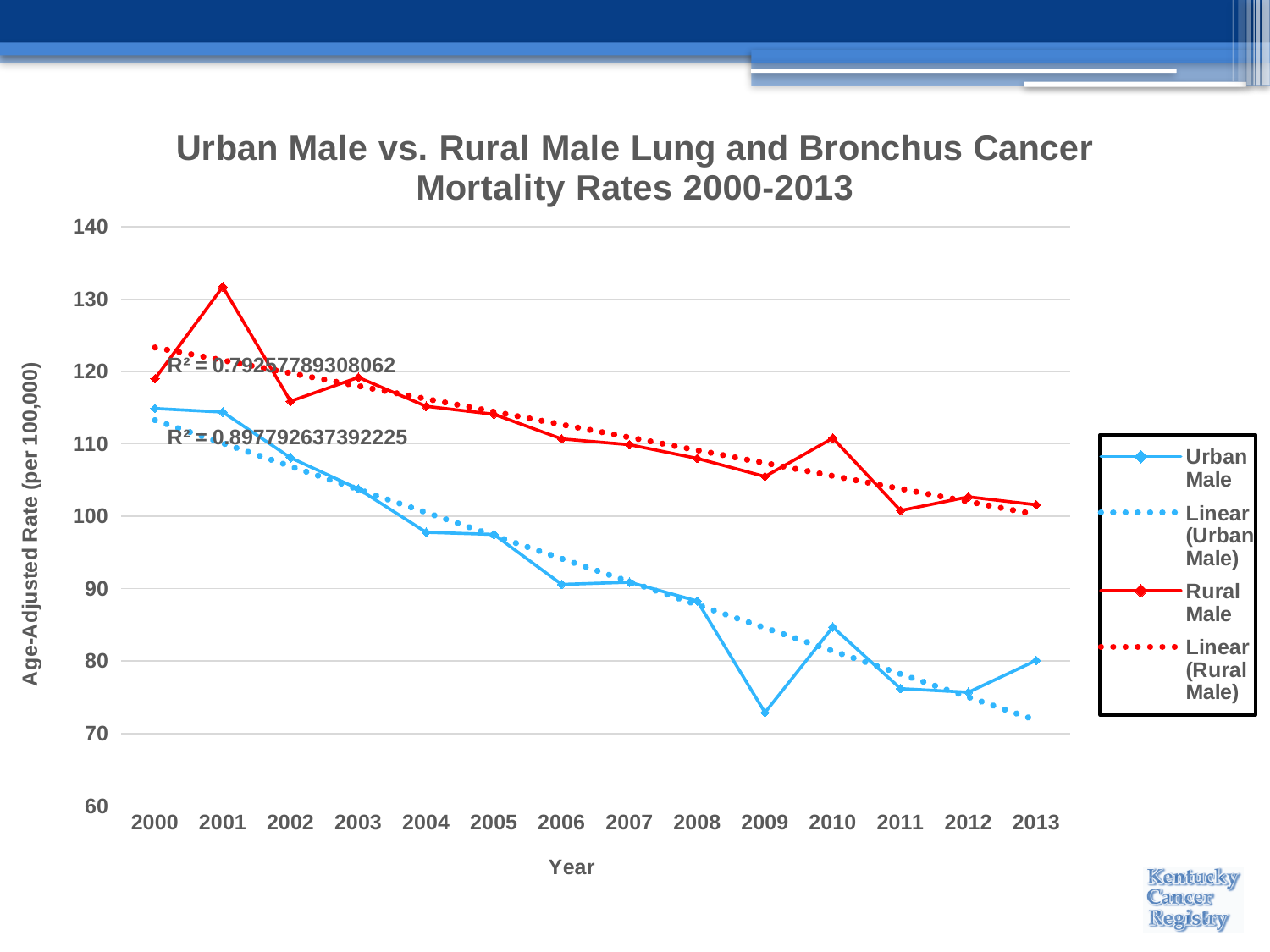
Does the Urban Male mortality rate generally rise or fall from 2000 to 2013? Fall Does the Rural Male mortality rate generally rise or fall from 2000 to 2013? Fall In which year does the Rural Male series reach its highest value? 2001 What kind of chart is shown on the slide? Line chart Is the Rural Male value for 2001 greater or less than 120? greater What is the label of the y axis? Age-Adjusted Rate (per 100,000) In which year does the Urban Male series reach its lowest value? 2009 In 2005, which series has the higher value, Urban Male or Rural Male? Rural Male How many years are plotted along the x axis? 14 How many entries does the legend list? 4 Is the Urban Male value for 2009 greater or less than 80? less What is the title of the chart? Urban Male vs. Rural Male Lung and Bronchus Cancer Mortality Rates 2000-2013